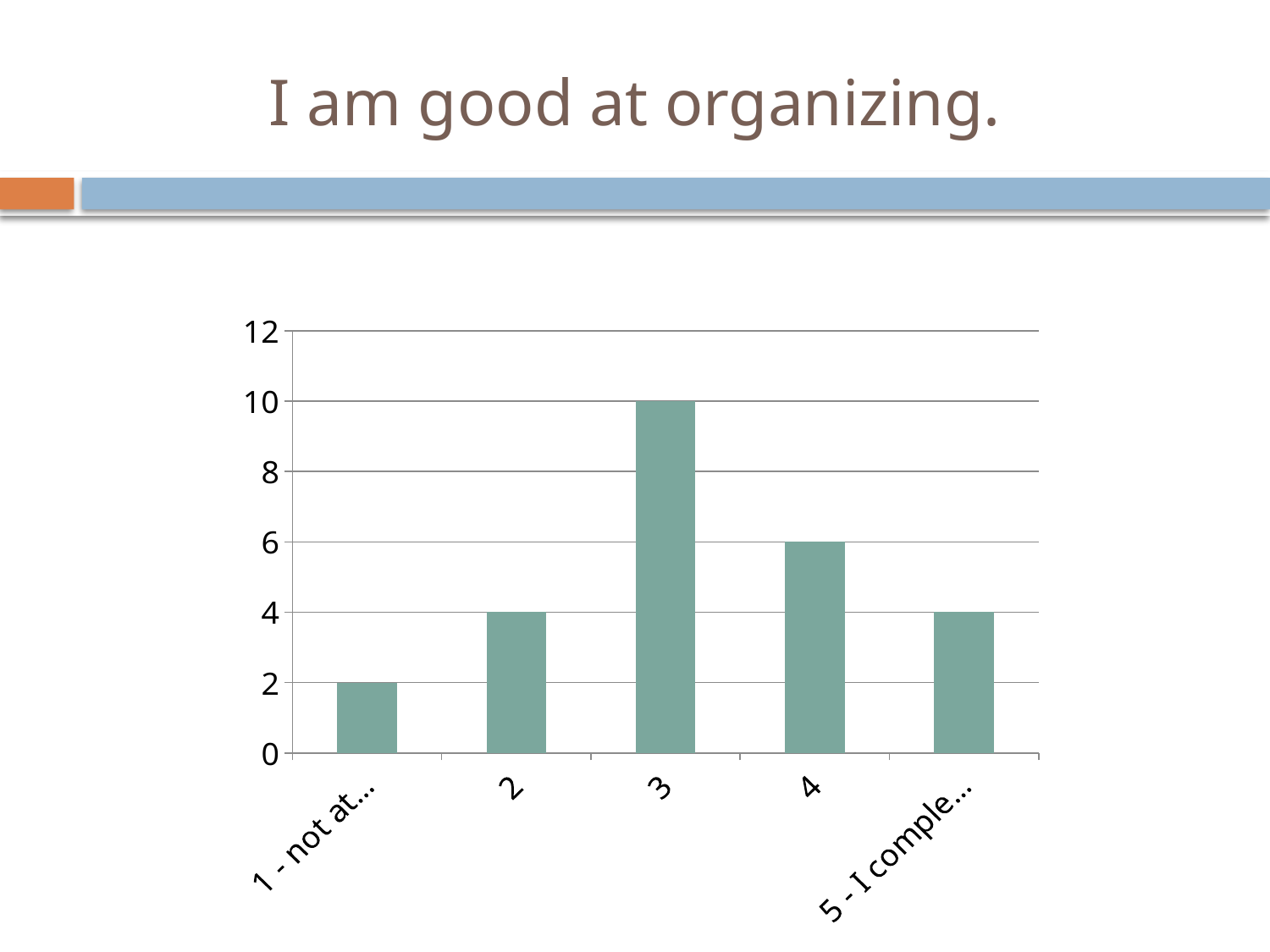
What is the value for the category labelled "1 - not at..."? 2 What is the value for category 4? 6 What is the value for category 3? 10 What kind of chart is shown on the slide? bar chart Which category has the lowest value? 1 - not at... Is the value for category 3 greater or less than 8? greater Which is larger, the value for category 4 or the value for category 2? category 4 How many bars (categories) does the chart show? 5 Which category has the highest value? 3 What is the title of the slide containing the chart? I am good at organizing. What is the value for category 2? 4 What is the difference between the values for category 3 and category 4? 4